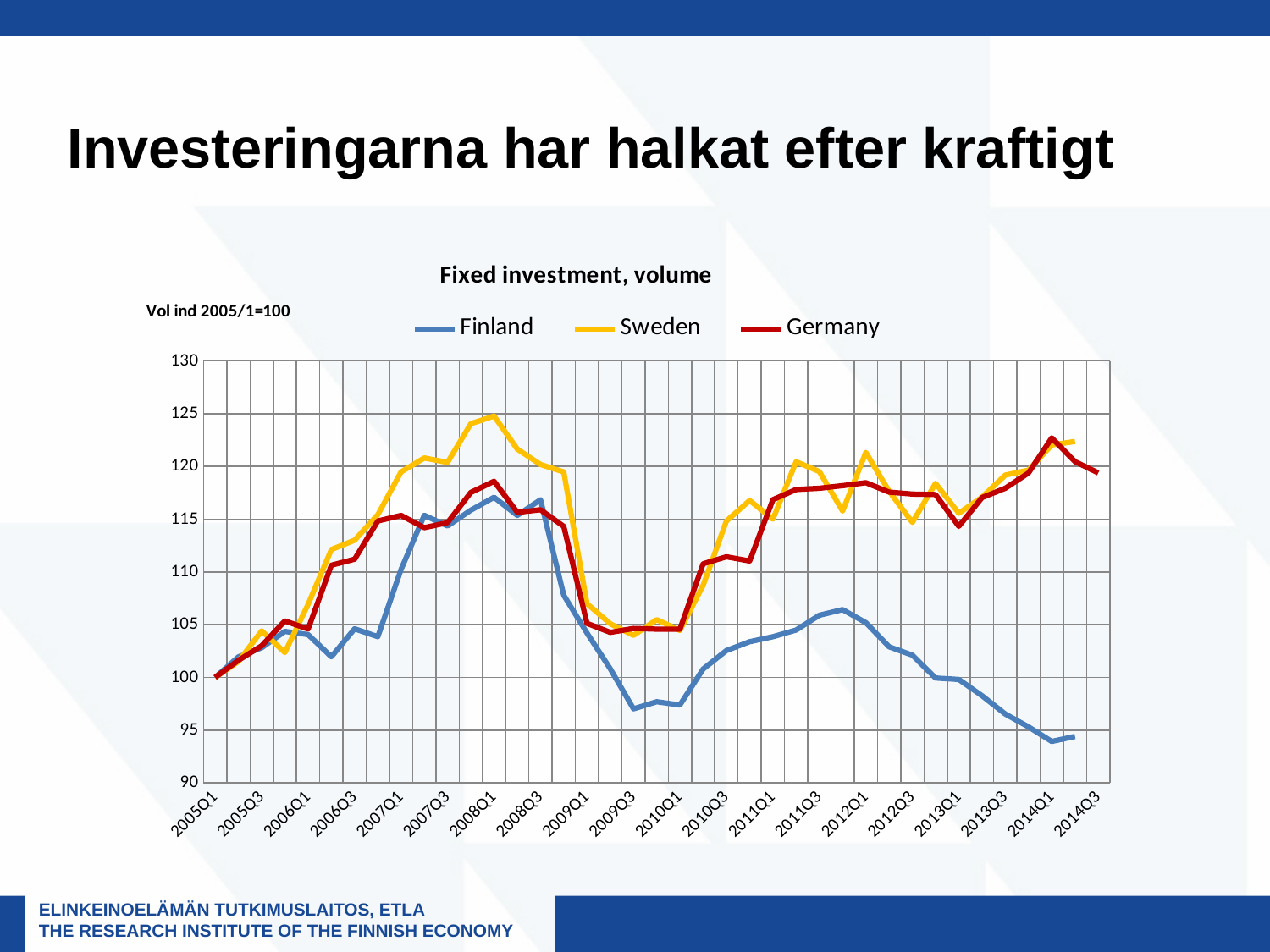
How many series does the legend of the chart list? 3 Which series has the highest value at 2008Q1? Sweden Is the value for Germany at 2009Q3 greater or less than 110? less What kind of chart is shown on the slide? line chart Is the value for Sweden at 2008Q1 greater or less than 120? greater Is the value for Finland at 2014Q1 greater or less than 100? less What is the title of the chart? Fixed investment, volume Which series has the lowest value at 2014Q1? Finland What is the value of all three series at 2005Q1? 100 Which series is drawn in yellow in the chart? Sweden Does the Finland series rise or fall between 2012Q1 and 2014Q1? fall